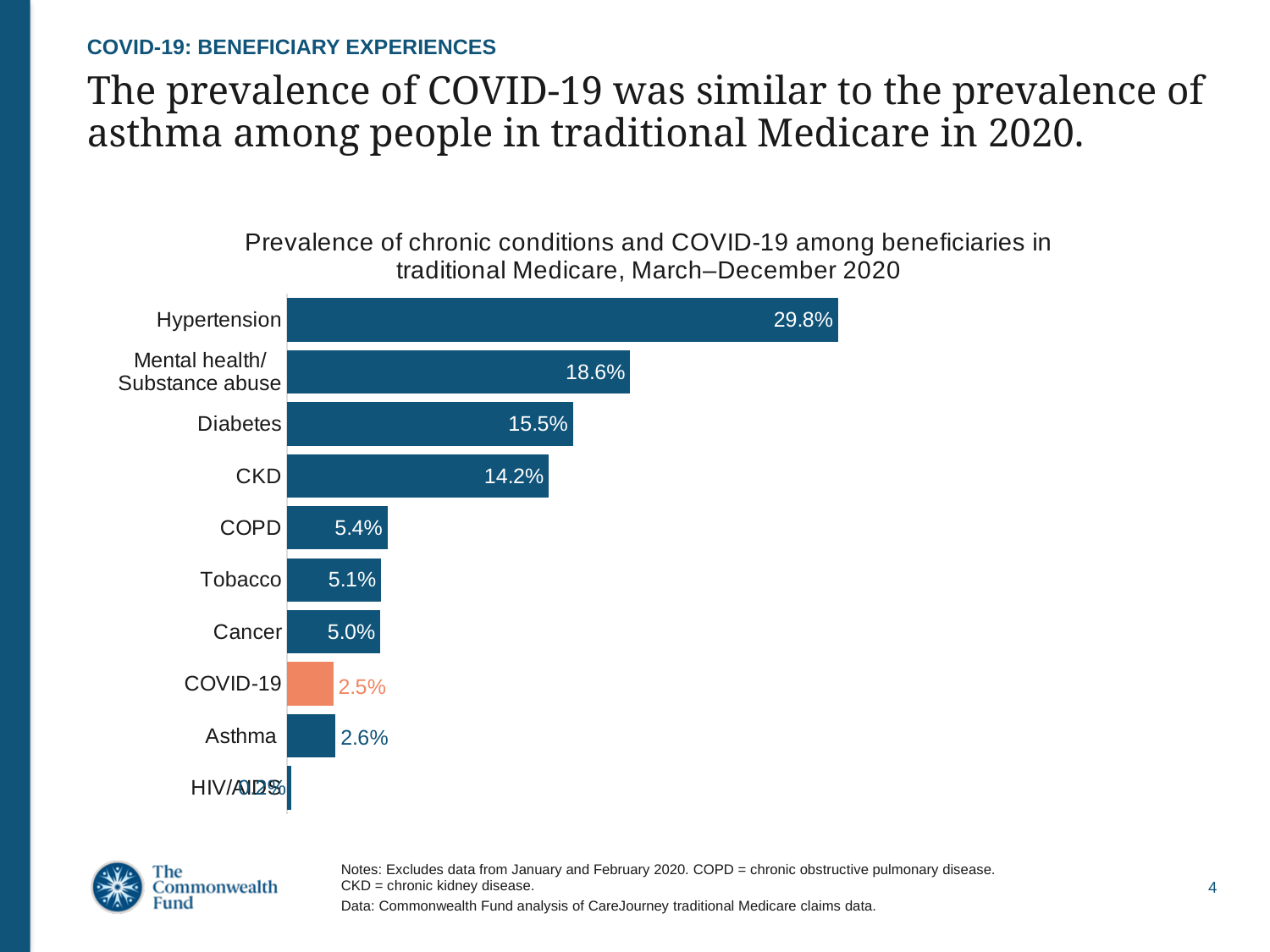
Which bar is shown in a different colour (orange) from the others? COVID-19 What is the difference in percentage points between asthma and COVID-19? 0.1 percentage points Which has a higher prevalence, diabetes or CKD? Diabetes What is the prevalence of hypertension shown in the chart? 29.8% Which condition has the highest prevalence in the chart? Hypertension What is the prevalence of COVID-19 shown in the chart? 2.5% What is the difference in percentage points between hypertension and mental health/substance abuse? 11.2 percentage points How many conditions are plotted in the chart? 10 What type of chart is shown on the slide? Bar chart Which condition has the lowest prevalence in the chart? HIV/AIDS What value is shown for asthma? 2.6% What value is shown for COPD? 5.4%